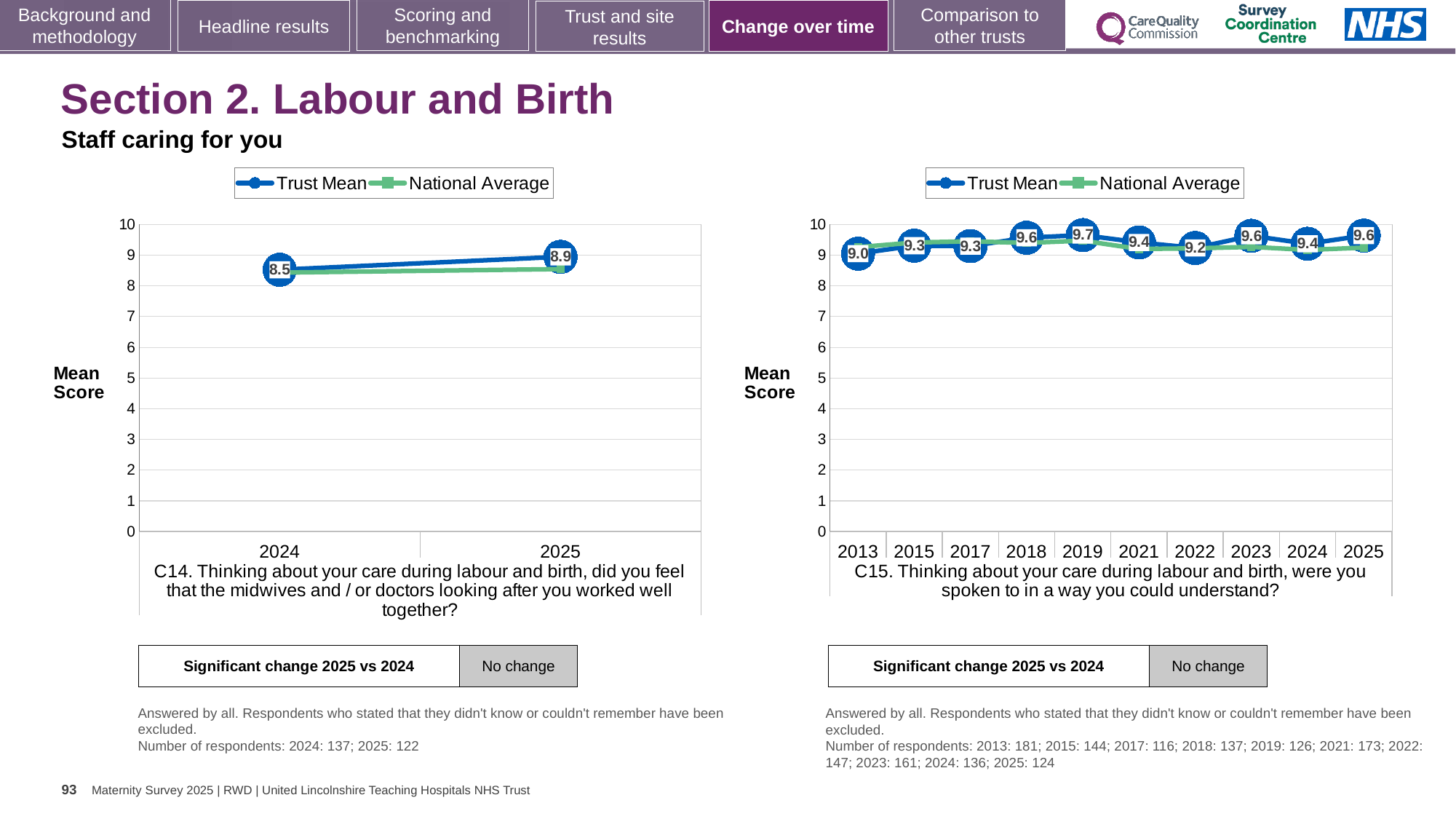
On the right chart (C15), which year has the lowest Trust Mean? 2013 On the right chart (C15), how many years are plotted on the x axis? 10 On the right chart (C15), what is the Trust Mean for 2019? 9.7 On the left chart (C14), what is the Trust Mean for 2025? 8.9 On the left chart (C14), by how much did the Trust Mean change from 2024 to 2025? 0.4 On the left chart (C14), what is the Trust Mean for 2024? 8.5 On the right chart (C15), which year has the highest Trust Mean? 2019 On the left chart (C14), does the Trust Mean rise or fall from 2024 to 2025? rise What kind of chart is the right chart (C15)? line chart On the right chart (C15), is the Trust Mean for 2022 higher or lower than the Trust Mean for 2023? lower On the left chart (C14), how many series does the legend list? 2 On the right chart (C15), what is the Trust Mean for 2013? 9.0